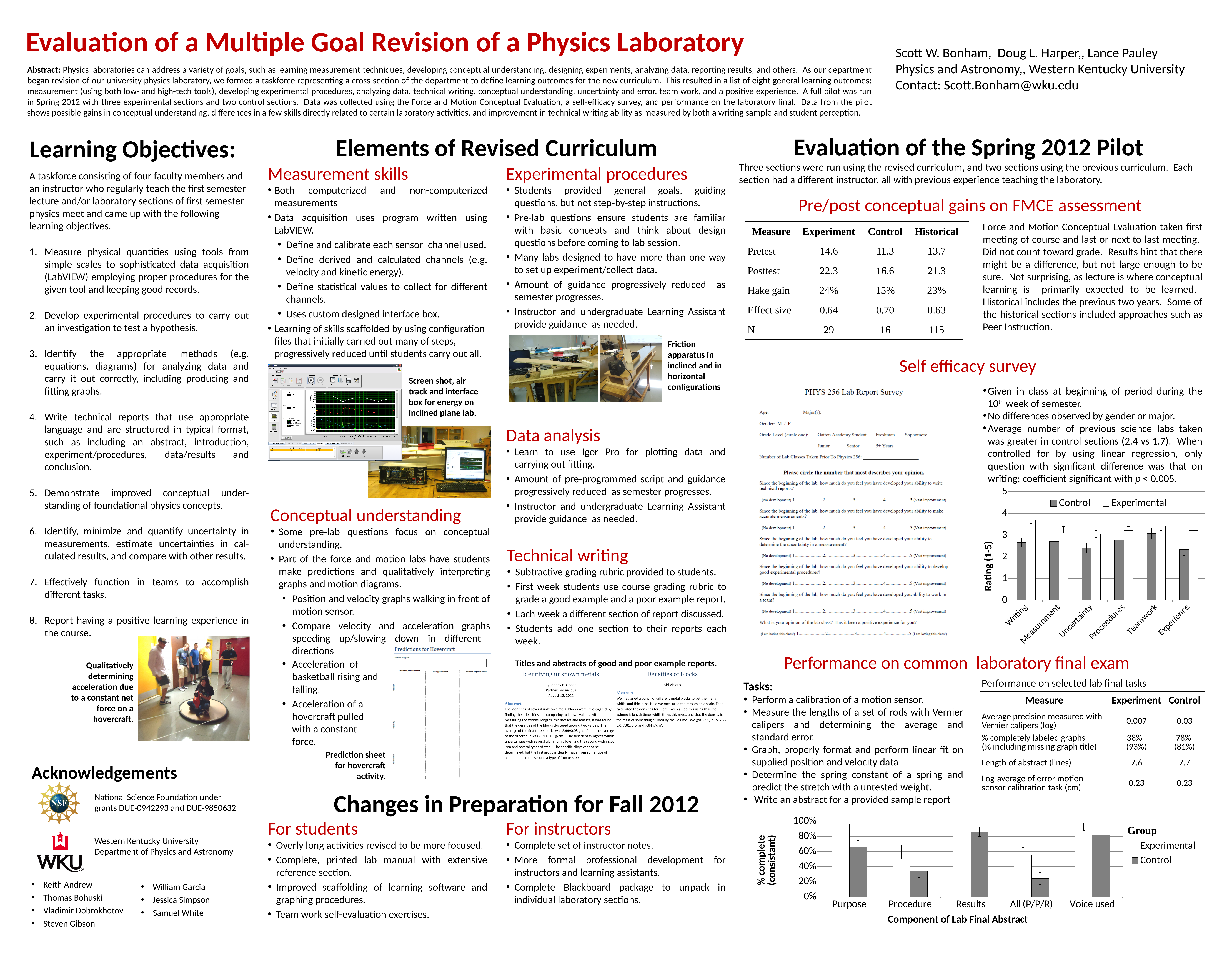
In the bottom-right lab final abstract chart, which component has the lowest Control value? All (P/P/R) What kind of chart is the chart at the bottom right showing % complete by Component of Lab Final Abstract? bar chart In the bottom-right lab final abstract chart, what is the title of the x axis? Component of Lab Final Abstract In the bottom-right lab final abstract chart, how many components are shown on the x axis? 5 In the bottom-right lab final abstract chart, is the Experimental value for Purpose greater or less than 80%? greater In the bottom-right lab final abstract chart, is the Control value for Procedure greater or less than 40%? less In the self efficacy survey chart, is the Control rating for Experience greater or less than 3? less In the self efficacy survey chart, which category has the highest Experimental rating? Writing In the self efficacy survey chart, how many categories are shown on the x axis? 6 In the self efficacy survey chart, how many series does the legend list? 2 In the self efficacy survey chart, for Writing, which group has the larger rating, Control or Experimental? Experimental